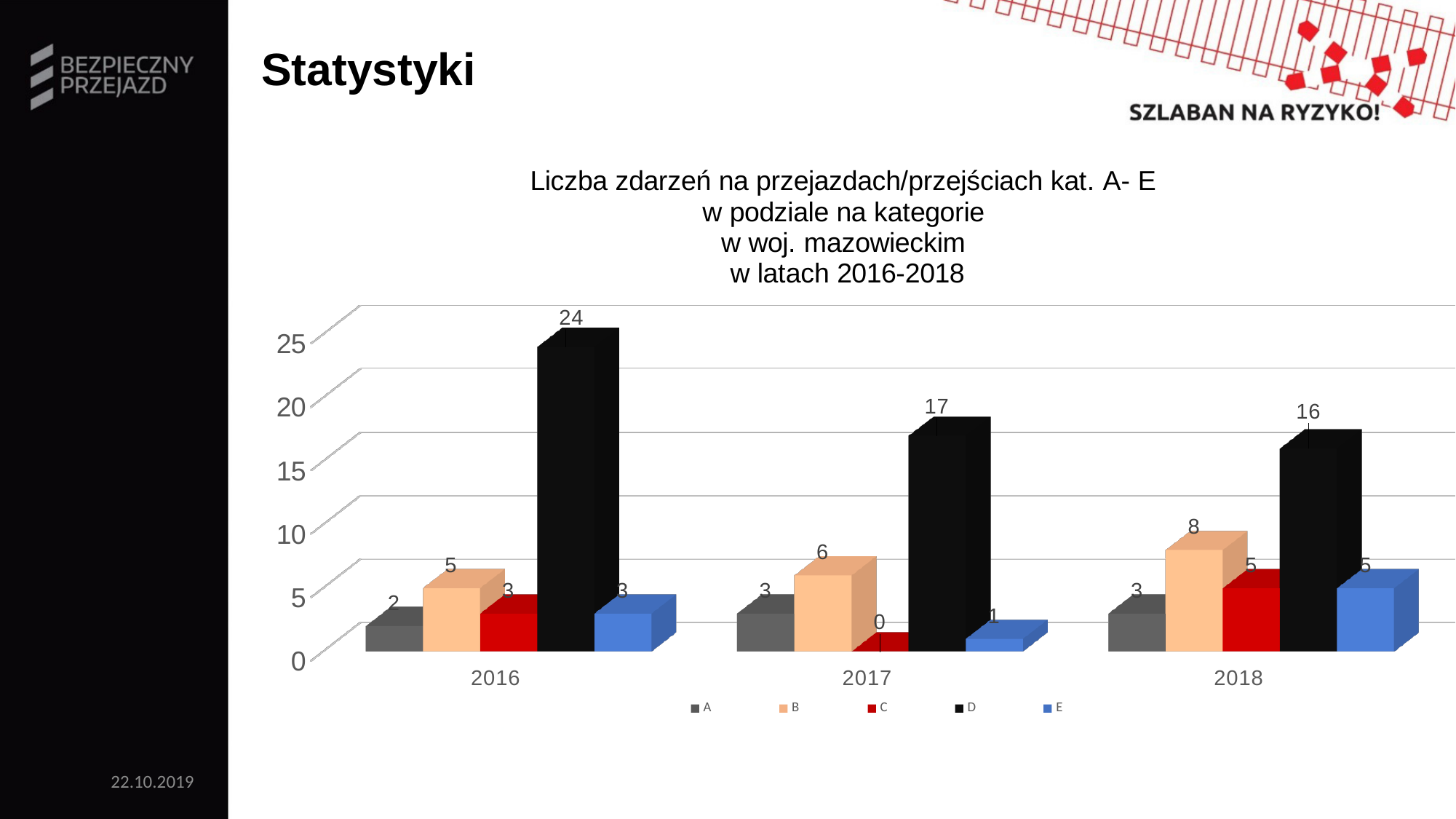
Do the values for series D rise or fall from 2016 to 2018? Fall What is the value for series C in 2017? 0 Which series has the highest value in 2018? D What is the value for series B in 2018? 8 Which is larger: the value for series B in 2017 or series B in 2018? B in 2018 Which series has the lowest value in 2017? C What is the value for series D in 2016? 24 What is the value for series E in 2017? 1 How many series does the legend list? 5 What is the difference between the value for series D in 2016 and series D in 2018? 8 How many years (categories) are shown on the x axis? 3 What kind of chart is shown on the slide? Bar chart